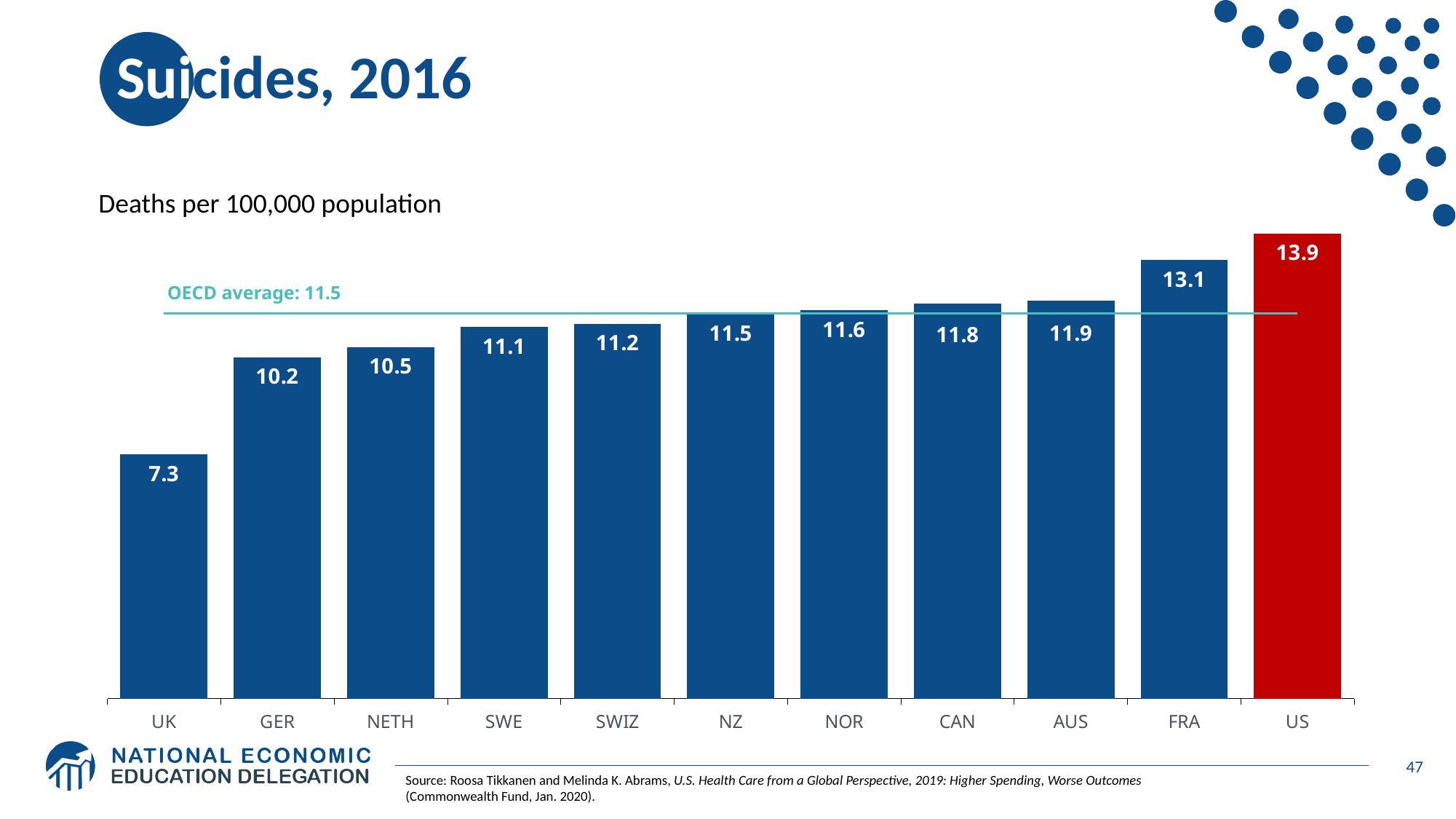
What is the difference between the values for FRA and CAN? 1.3 Do the values rise or fall moving from left to right across the chart? Rise What OECD average value is marked by the horizontal line on the chart? 11.5 How many countries are shown on the chart? 11 Which country has the highest value on the chart? US What kind of chart is shown on the slide? Bar chart What is the difference between the values for the US and the UK? 6.6 What is the value shown for GER? 10.2 What is the suicide rate shown for the US? 13.9 Which has a higher value, SWE or AUS? AUS What is the value shown for NOR? 11.6 Which country has the lowest value on the chart? UK